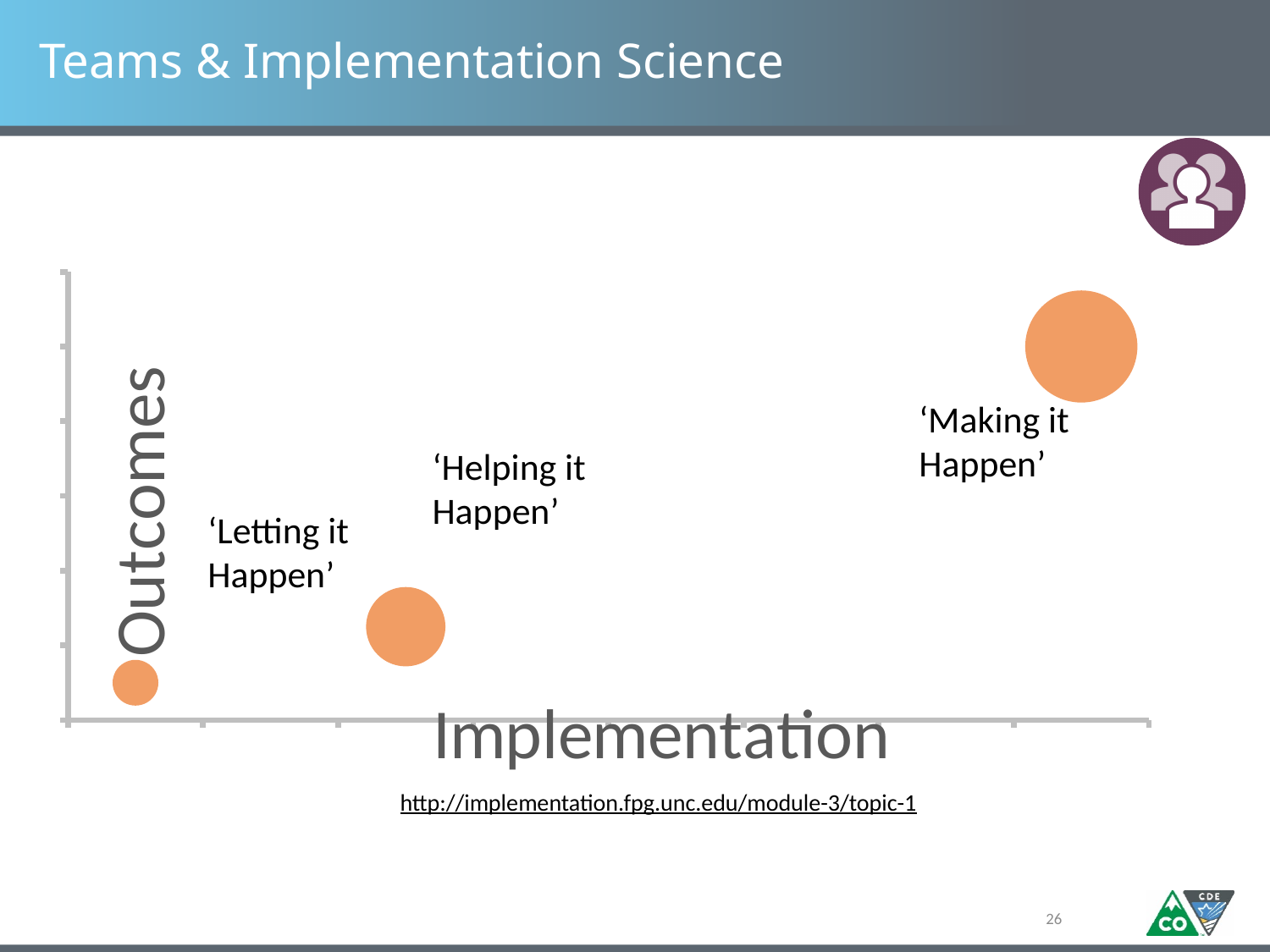
Which labelled point has the highest Outcomes value? 'Making it Happen' Which labelled point is furthest to the left on the Implementation axis? 'Letting it Happen' Which point is further along the Implementation axis, 'Making it Happen' or 'Helping it Happen'? 'Making it Happen' Which labelled point has the largest bubble? 'Making it Happen' Do Outcomes rise or fall as Implementation increases along the x axis? Rise What is the label of the horizontal axis of the chart? Implementation What is the label of the vertical axis of the chart? Outcomes How many bubbles (data points) are plotted on the chart? 3 Which labelled point has the lowest Outcomes value? 'Letting it Happen' Which point is higher on the Outcomes axis, 'Helping it Happen' or 'Letting it Happen'? 'Helping it Happen' What kind of chart is shown on the slide? Bubble chart